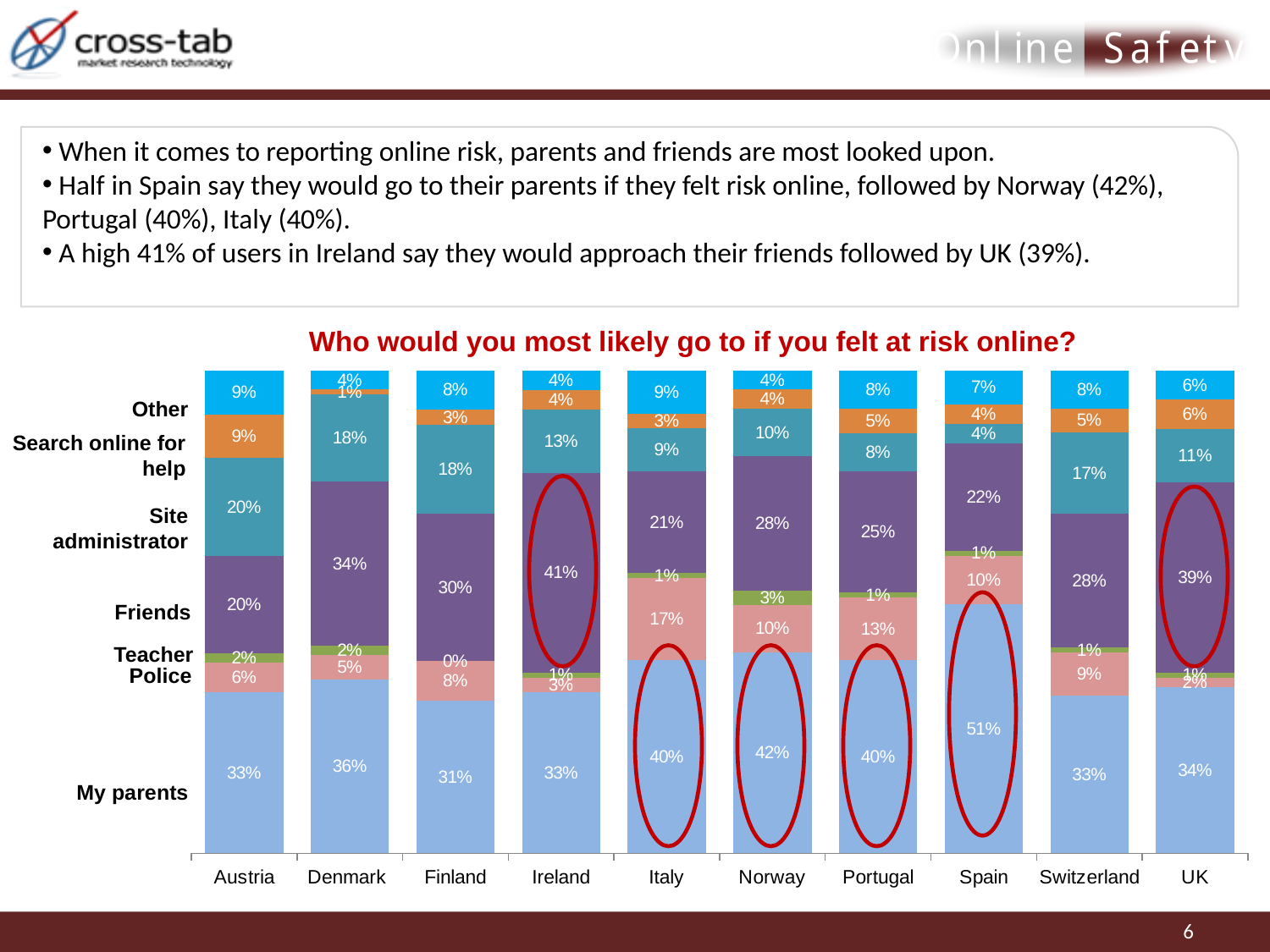
Which country has the highest 'My parents' percentage? Spain Which is larger: the Police percentage for Italy or for Portugal? Italy What is the title of the chart? Who would you most likely go to if you felt at risk online? How many response categories (series) are stacked in each bar? 7 What percentage of respondents in Ireland said they would go to friends? 41% What is the total of all segments in the Italy bar? 100% What is the Site administrator value for Denmark? 18% What percentage of respondents in Spain said they would go to their parents? 51% What type of chart is shown on the slide? Stacked bar chart What is the difference between the Friends percentage for the UK and for Austria? 19% How many countries are shown on the x axis? 10 Which country has the lowest 'My parents' percentage? Finland